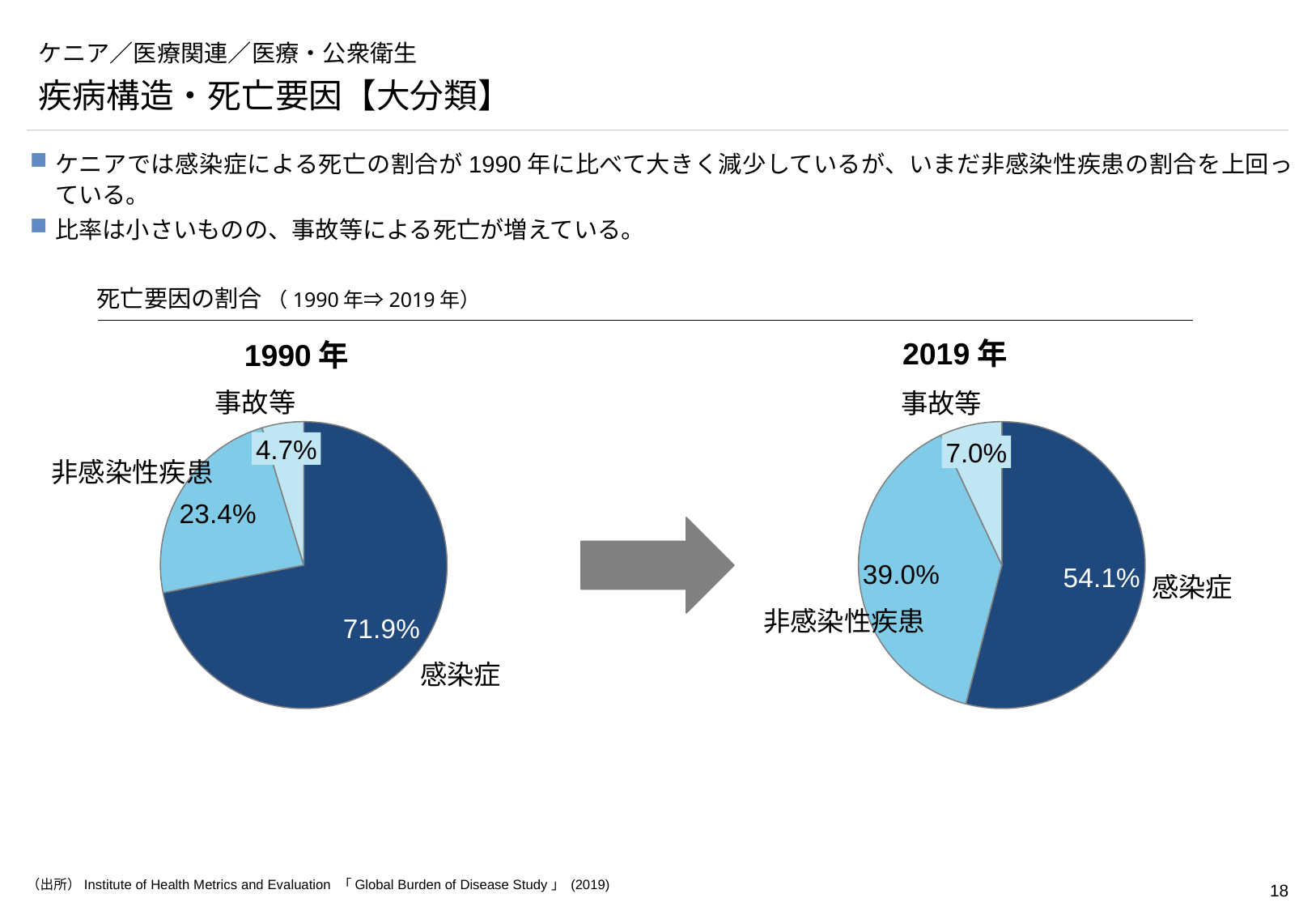
What is the difference between the 感染症 share in the 1990年 chart and the 感染症 share in the 2019年 chart? 17.8% How many categories does the 1990年 pie chart show? 3 In the 1990年 pie chart, what is the share for 非感染性疾患? 23.4% In the 2019年 pie chart, what is the difference between the 感染症 share and the 非感染性疾患 share? 15.1% Which is larger: the 事故等 share in the 1990年 chart or the 事故等 share in the 2019年 chart? 2019年 In the 1990年 pie chart, which category has the smallest share? 事故等 What kind of chart is used for the 2019年 data? Pie chart In the 2019年 pie chart, what is the share for 非感染性疾患? 39.0% In the 2019年 pie chart, which category has the largest share? 感染症 In the 1990年 pie chart, what is the share for 感染症? 71.9% In the 2019年 pie chart, what is the share for 事故等? 7.0% What is the title of the chart section containing the two pie charts? 死亡要因の割合（1990年⇒2019年）